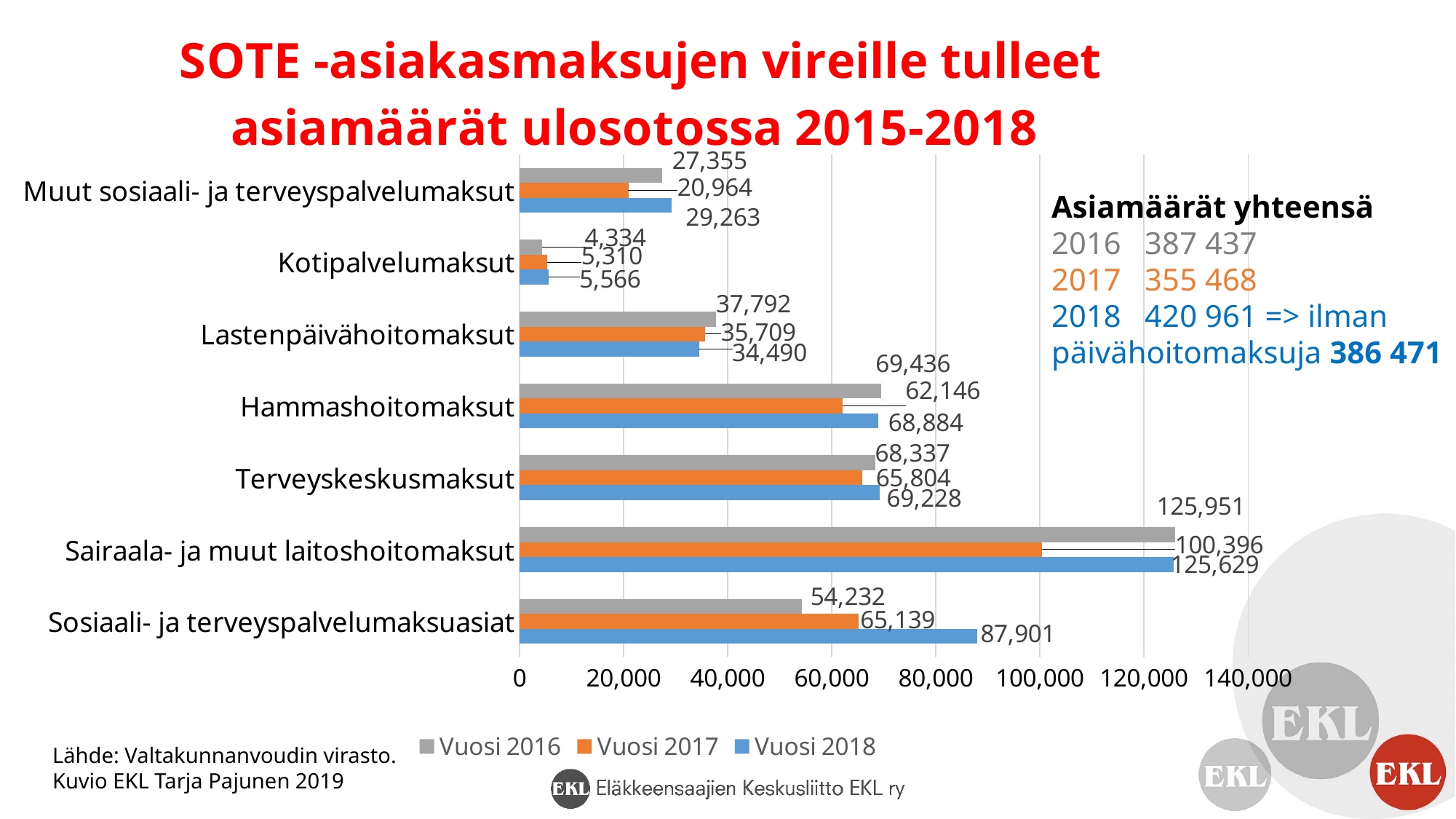
What is the value for Vuosi 2017 in the Hammashoitomaksut category? 62,146 What is the difference between the Vuosi 2018 and Vuosi 2016 values for Sosiaali- ja terveyspalvelumaksuasiat? 33,669 What is the difference between the Vuosi 2016 and Vuosi 2017 values for Sairaala- ja muut laitoshoitomaksut? 25,555 What is the value for Vuosi 2018 in the Sosiaali- ja terveyspalvelumaksuasiat category? 87,901 How many series does the legend list? 3 Which category has the lowest value for Vuosi 2017? Kotipalvelumaksut For Sosiaali- ja terveyspalvelumaksuasiat, which is larger: the Vuosi 2016 value or the Vuosi 2017 value? Vuosi 2017 What is the value for Vuosi 2018 in the Lastenpäivähoitomaksut category? 34,490 How many categories are shown on the chart? 7 Which category has the highest value for Vuosi 2018? Sairaala- ja muut laitoshoitomaksut What is the value for Vuosi 2016 in the Kotipalvelumaksut category? 4,334 What kind of chart is shown on the slide? Bar chart